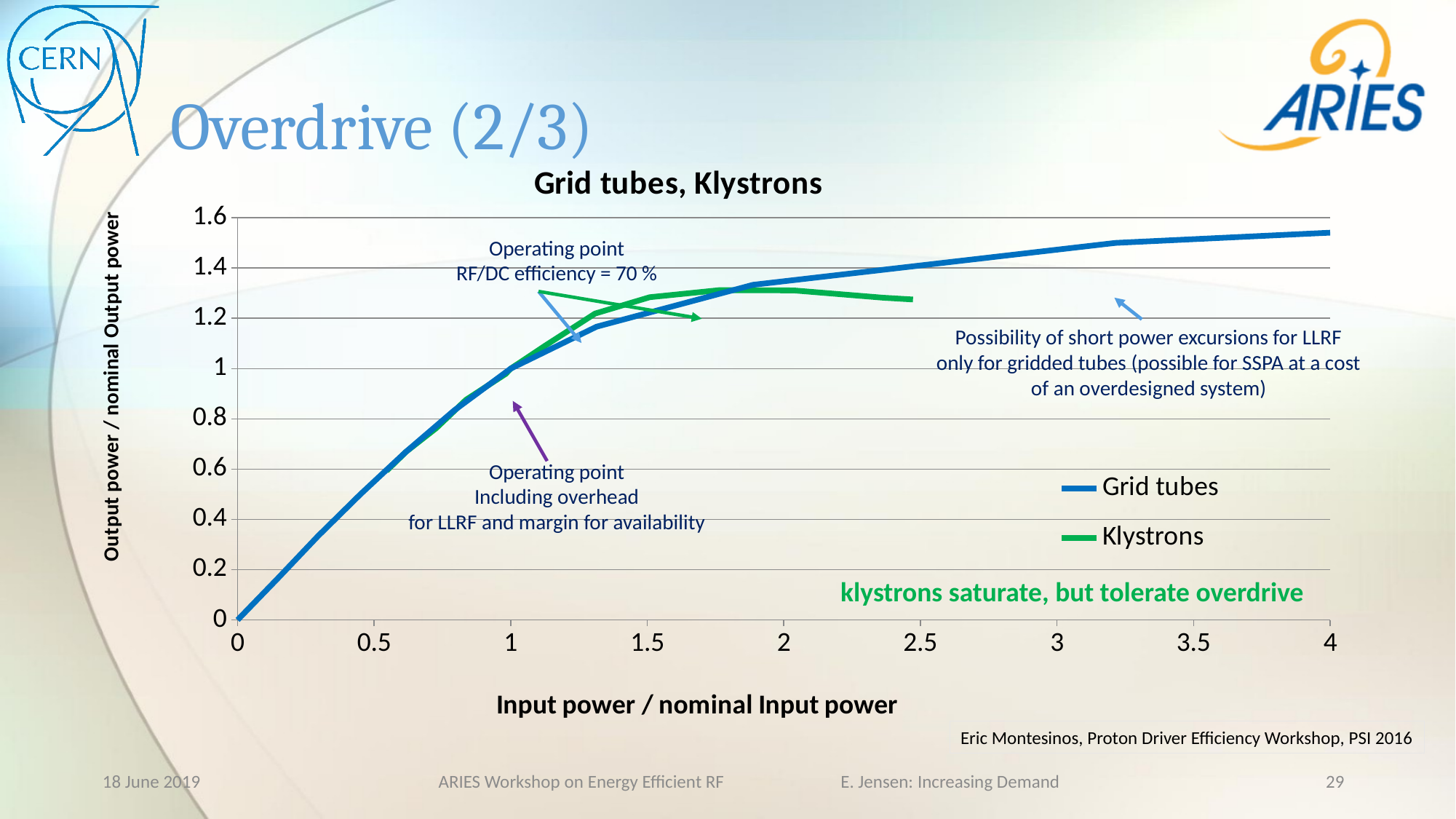
Does the Grid tubes curve rise or fall as the input power ratio increases from 0 to 4? rise At an input power ratio of 2.5, which series has the higher output power ratio, Grid tubes or Klystrons? Grid tubes How many series does the chart legend list? 2 Is the Grid tubes value at an input power ratio of 0.5 greater or less than 0.4? greater Which series is drawn in green? Klystrons Is the Grid tubes value at an input power ratio of 3 greater or less than 1.2? greater What kind of chart is shown on the slide? line chart What is the label of the x axis? Input power / nominal Input power Is the Klystrons value at an input power ratio of 2 greater or less than 1.2? greater What is the title of the chart? Grid tubes, Klystrons